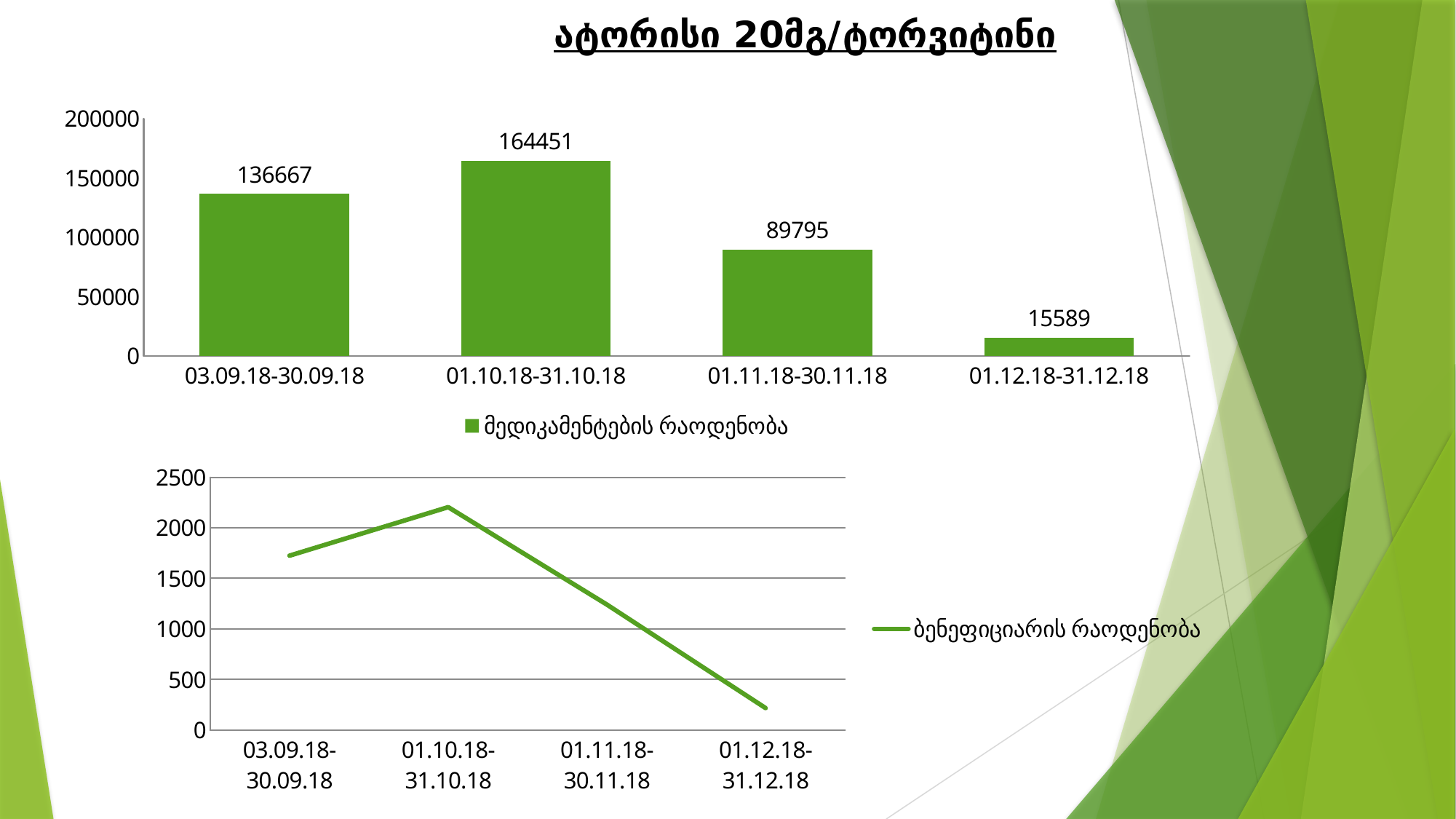
In the top bar chart, what is the value for 03.09.18-30.09.18? 136667 In the top bar chart, which period has the highest value? 01.10.18-31.10.18 In the top bar chart, what is the value for 01.12.18-31.12.18? 15589 What is the legend entry of the top bar chart? მედიკამენტების რაოდენობა In the bottom line chart, is the value for 01.10.18-31.10.18 greater or less than 2000? greater What kind of chart is the bottom chart on the slide? line chart In the top bar chart, what is the difference between the values for 01.10.18-31.10.18 and 01.11.18-30.11.18? 74656 What kind of chart is the top chart on the slide? bar chart In the top bar chart, which period has the lowest value? 01.12.18-31.12.18 How many bars are in the top bar chart? 4 In the top bar chart, which is larger: the value for 03.09.18-30.09.18 or for 01.11.18-30.11.18? 03.09.18-30.09.18 In the bottom line chart, is the value for 01.12.18-31.12.18 greater or less than 500? less